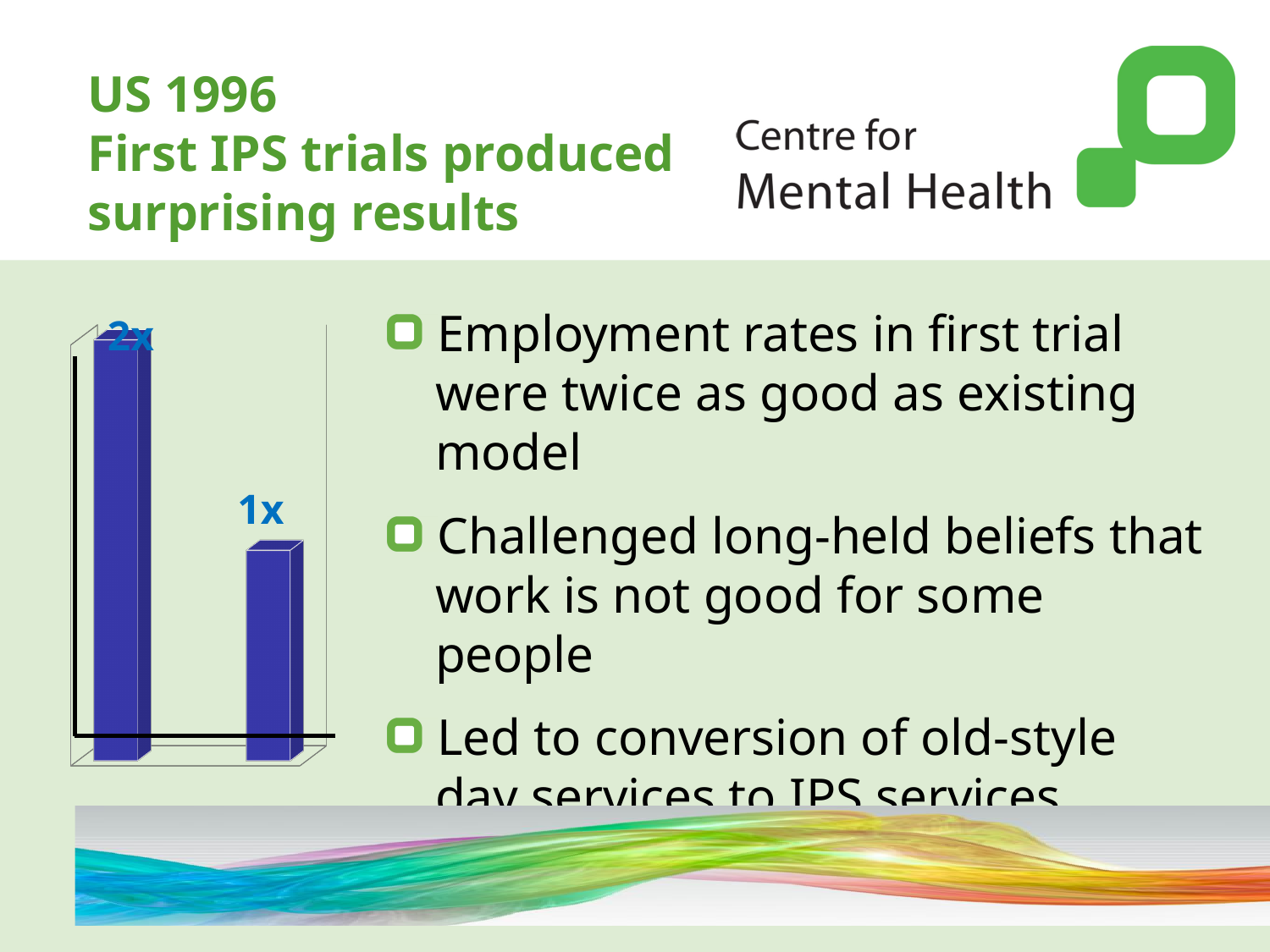
Does the chart have a legend? no What colour are the bars in the chart? blue What is the data label on the left bar of the chart? 2x How many bars does the chart show? 2 Which bar in the chart is the shortest? the right bar (1x) Which bar in the chart is the tallest? the left bar (2x) What kind of chart is shown on the left of the slide? bar chart What is the data label on the right bar of the chart? 1x Is the left bar or the right bar larger in the chart? the left bar